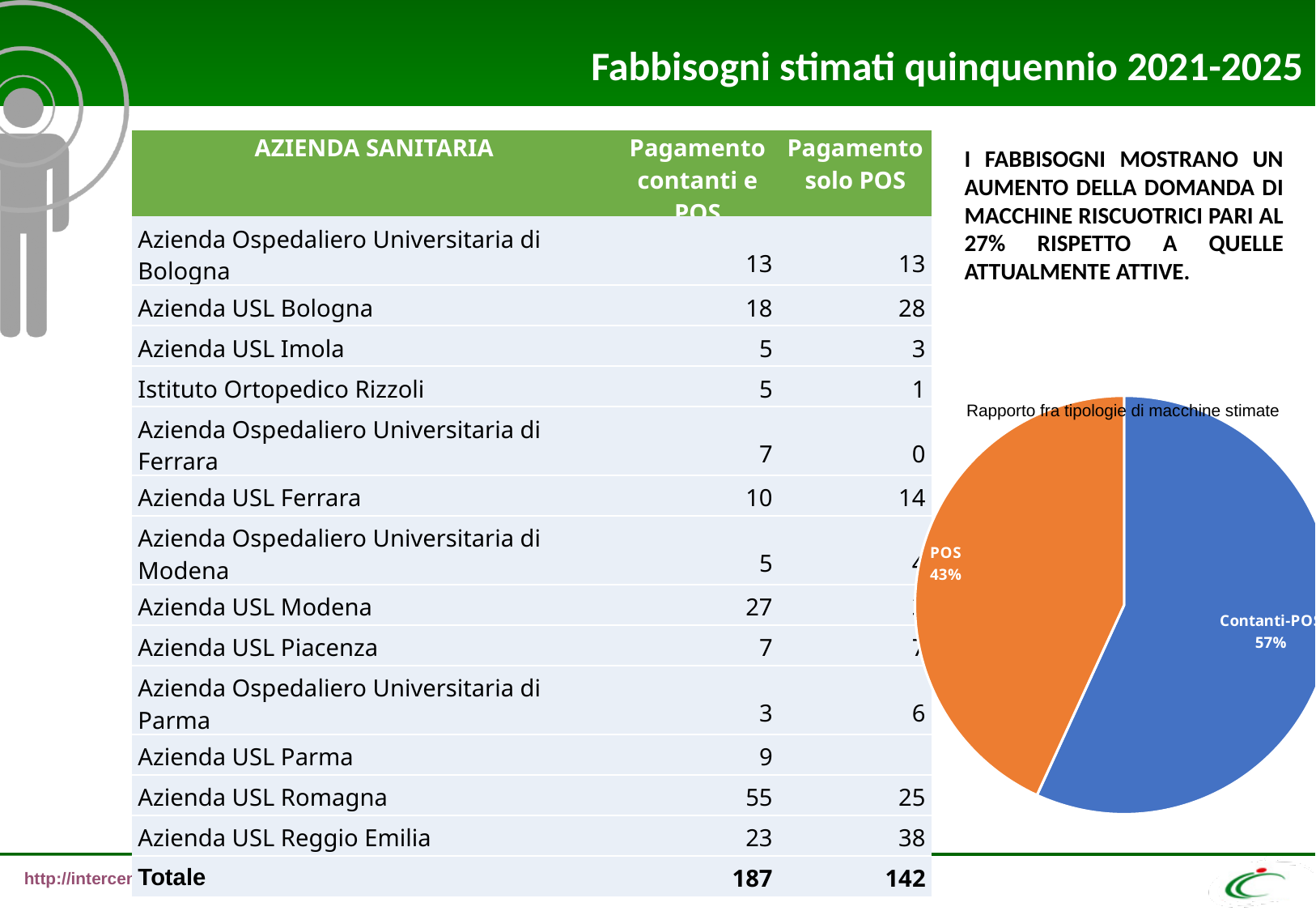
Which slice of the pie chart is the largest? Contanti-POS In the pie chart, what share is shown for Contanti-POS? 57% Which slice of the pie chart is the smallest? POS In the pie chart, what share is shown for POS? 43% How many slices does the pie chart have? 2 What is the difference in percentage points between the Contanti-POS slice and the POS slice in the pie chart? 14 What kind of chart is shown on the slide? pie chart What is the title of the pie chart? Rapporto fra tipologie di macchine stimate In the pie chart, which is larger: the POS slice or the Contanti-POS slice? Contanti-POS Is the share of the POS slice in the pie chart greater or less than 50%? less What colour is the POS slice in the pie chart? orange